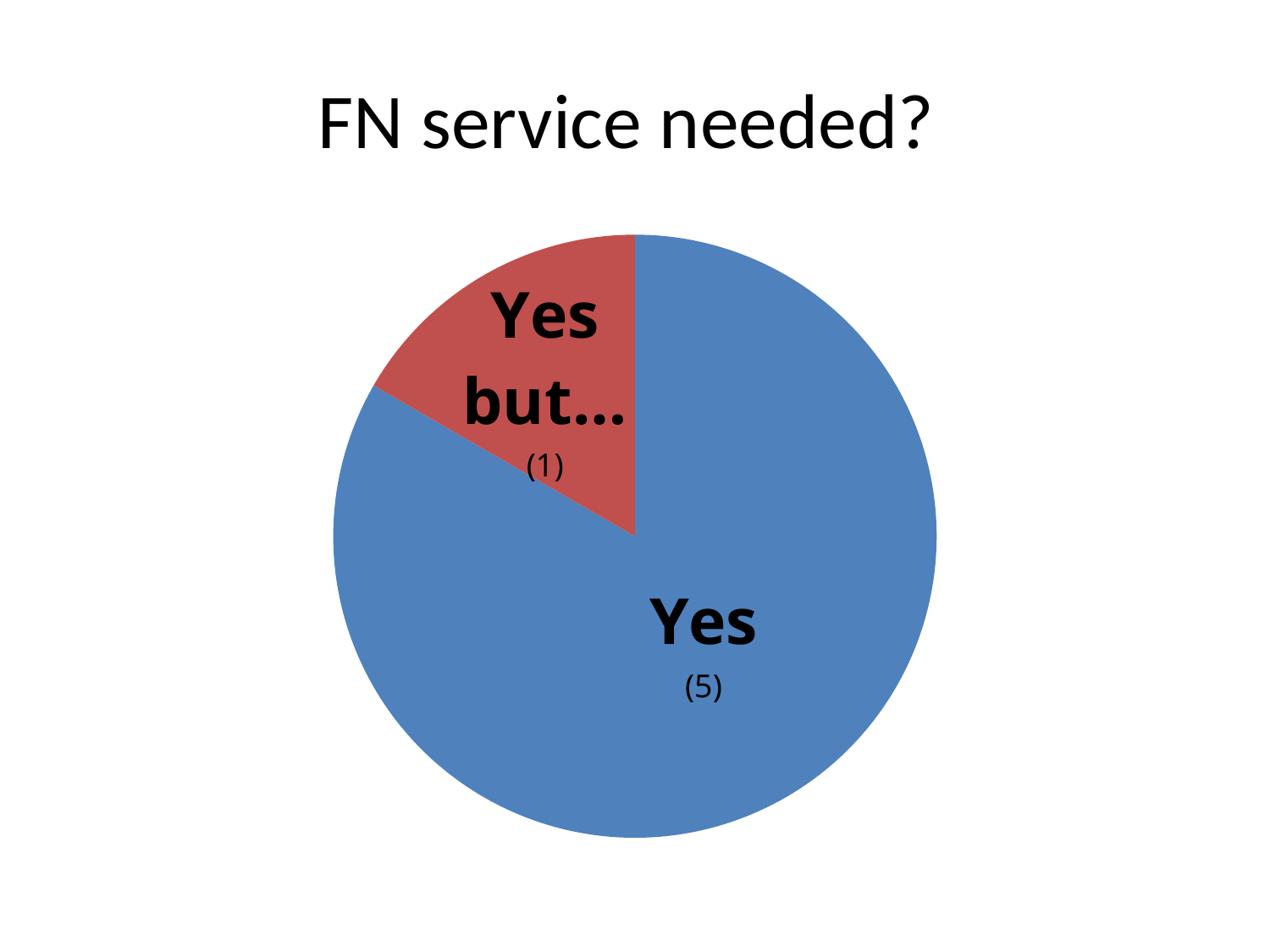
What kind of chart is shown on the slide? pie chart What colour is the "Yes but..." slice? red Which is larger, the "Yes" slice or the "Yes but..." slice? Yes What is the value shown for the "Yes but..." slice? 1 What is the difference between the "Yes" and "Yes but..." values? 4 Which slice is the smallest? Yes but... What is the total of all slices in the pie chart? 6 Which slice is the largest? Yes How many slices does the pie chart have? 2 What is the value shown for the "Yes" slice? 5 What is the title of the chart? FN service needed?